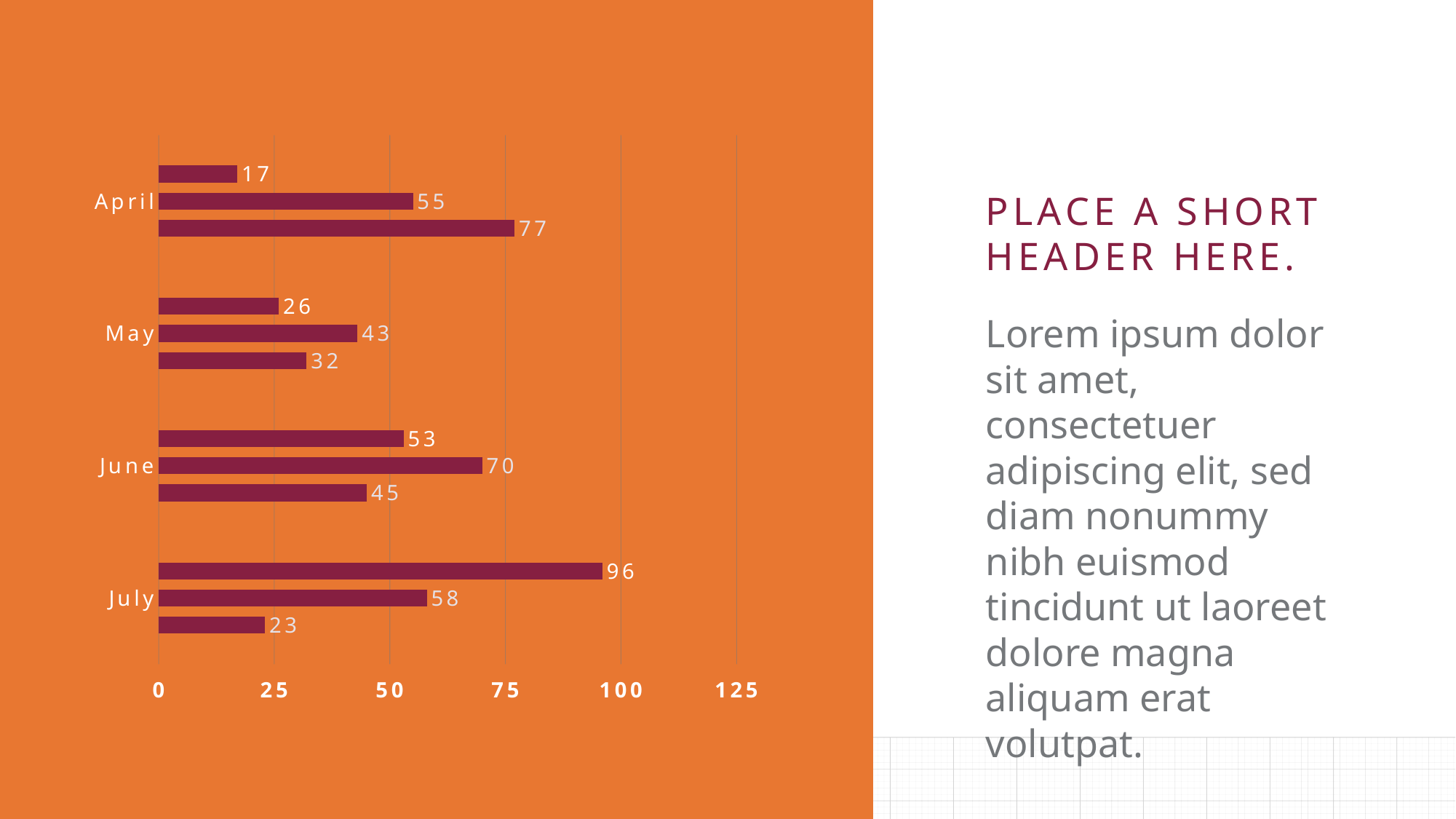
Which month has the single shortest bar on the chart? April What is the value of the top bar for July? 96 What kind of chart is shown on the slide? bar chart What is the highest value shown on the horizontal axis? 125 What is the value of the bottom bar for June? 45 Which month has the single longest bar on the chart? July Is the value of the bottom bar for April greater or less than 75? greater What is the value of the bottom bar for April? 77 What is the value of the middle bar for May? 43 Which is larger: the middle bar for June or the middle bar for April? the middle bar for June What is the difference between the top bar for July (96) and the bottom bar for July (23)? 73 How many categories (months) are shown on the chart? 4